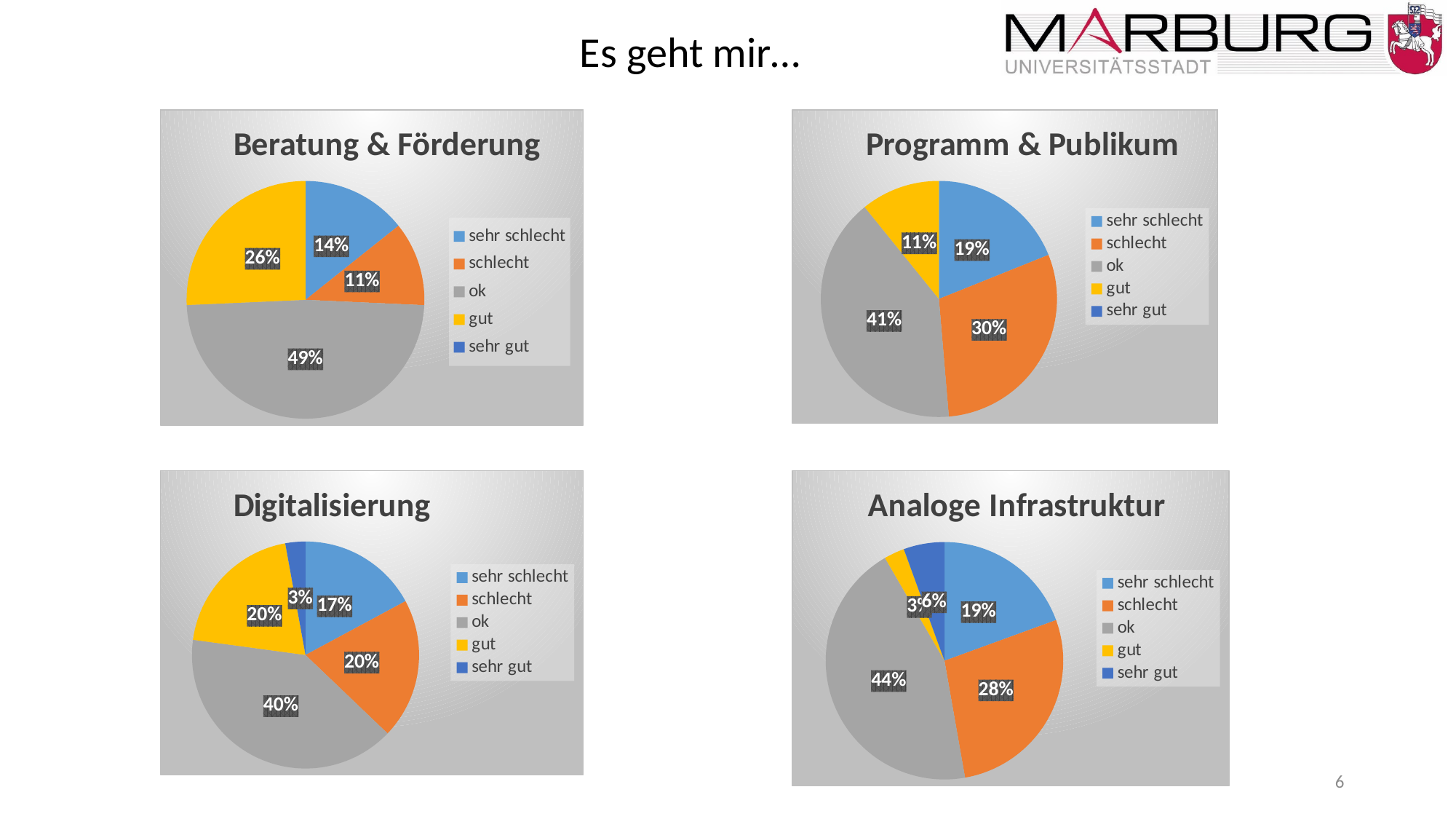
In the Digitalisierung chart, which category has the smallest slice? sehr gut What type of chart is used for Beratung & Förderung? pie chart In the Analoge Infrastruktur chart, what share is "ok"? 44% In the Beratung & Förderung chart, what share of responses is "ok"? 49% How many entries does the legend of the Digitalisierung chart list? 5 In the Programm & Publikum chart, which category has the largest slice? ok In the Digitalisierung chart, is the "schlecht" slice larger than the "gut" slice, or are they equal? equal In the Beratung & Förderung chart, what percentage is "gut"? 26% In the Programm & Publikum chart, what is the difference between the "ok" and "gut" shares? 30% In the Analoge Infrastruktur chart, which is larger, "sehr schlecht" or "schlecht"? schlecht In the Programm & Publikum chart, what share is "schlecht"? 30% In the Digitalisierung chart, what share is "sehr gut"? 3%